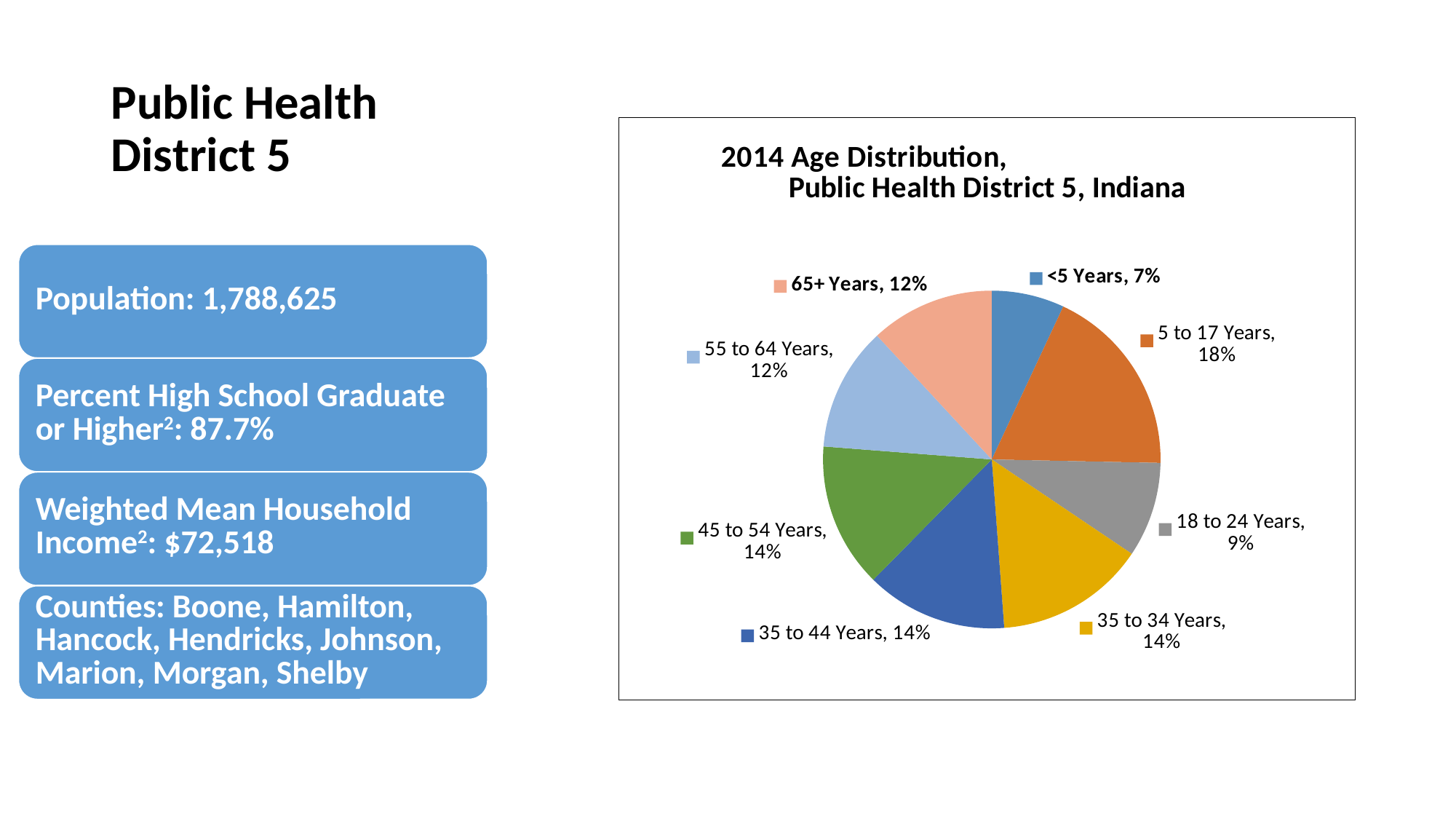
What share of the pie is the 5 to 17 Years slice? 18% Which age group has the smallest slice of the pie? <5 Years What is the chart's title? 2014 Age Distribution, Public Health District 5, Indiana Which is larger, the 55 to 64 Years slice or the 45 to 54 Years slice? 45 to 54 Years What colour is the 35 to 34 Years slice? yellow What kind of chart is shown on the slide? pie chart Which age group has the largest slice of the pie? 5 to 17 Years What is the difference in percentage points between the 5 to 17 Years slice and the 18 to 24 Years slice? 9 What percentage is shown for the 65+ Years slice? 12% How many age groups (slices) does the pie chart show? 8 What percentage is shown for the <5 Years slice? 7% What percentage is shown for the 18 to 24 Years slice? 9%